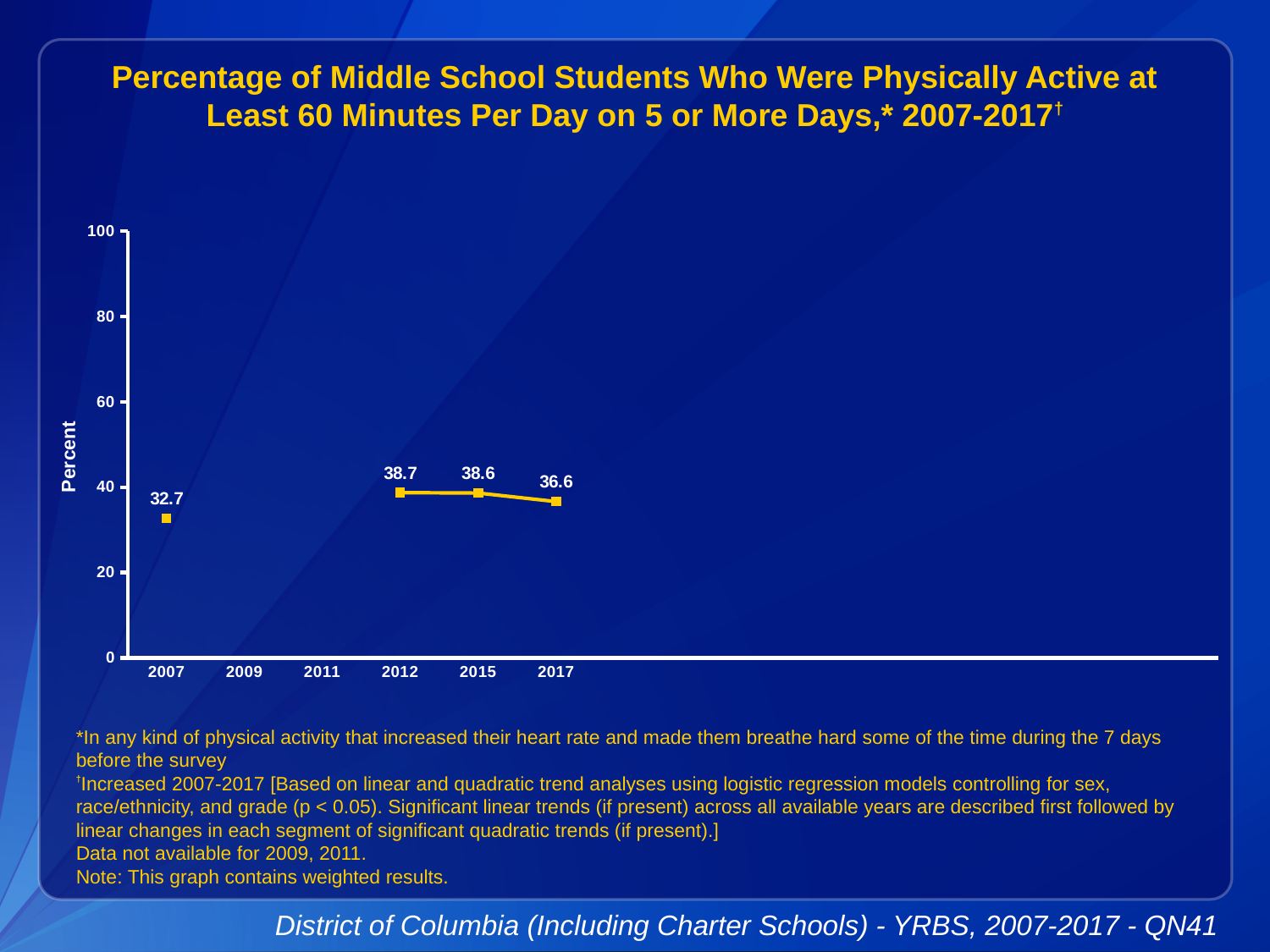
What value is plotted for 2015? 38.6 Which is larger, the value for 2007 or the value for 2017? 2017 What is the difference between the 2015 value and the 2017 value? 2.0 What kind of chart is shown on the slide? Line chart How many data points are plotted on the chart? 4 What was the percentage of middle school students who were physically active at least 60 minutes per day on 5 or more days in 2007? 32.7 What is the label on the vertical axis? Percent Which year has the lowest plotted value? 2007 Which year has the highest plotted value? 2012 What is the difference between the 2012 value and the 2007 value? 6.0 What value is plotted for 2012? 38.7 What value is plotted for 2017? 36.6